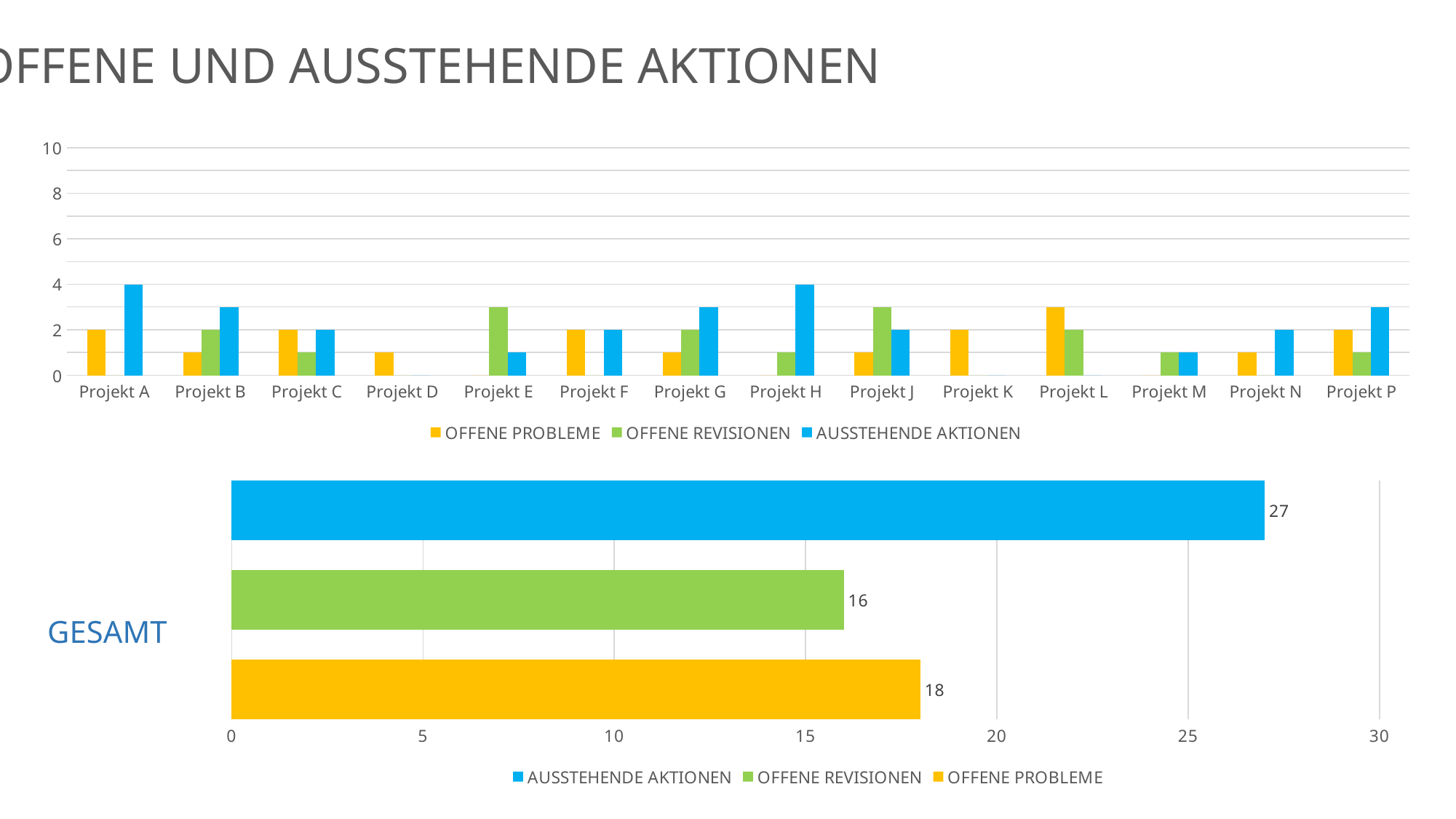
In the bottom chart (GESAMT), which series has the highest value? AUSSTEHENDE AKTIONEN In the top chart, what is the value of AUSSTEHENDE AKTIONEN for Projekt A? 4 In the bottom chart (GESAMT), what is the difference between AUSSTEHENDE AKTIONEN and OFFENE REVISIONEN? 11 In the bottom chart (GESAMT), what is the value for AUSSTEHENDE AKTIONEN? 27 In the bottom chart (GESAMT), what is the value for OFFENE PROBLEME? 18 In the top chart, how many projects are shown on the x axis? 14 In the bottom chart (GESAMT), which series has the lowest value? OFFENE REVISIONEN What kind of chart is the bottom chart (GESAMT)? Bar chart In the bottom chart (GESAMT), which is larger: OFFENE PROBLEME or OFFENE REVISIONEN? OFFENE PROBLEME In the bottom chart (GESAMT), what is the value for OFFENE REVISIONEN? 16 In the top chart, what is the value of OFFENE PROBLEME for Projekt K? 2 In the top chart, how many series does the legend list? 3